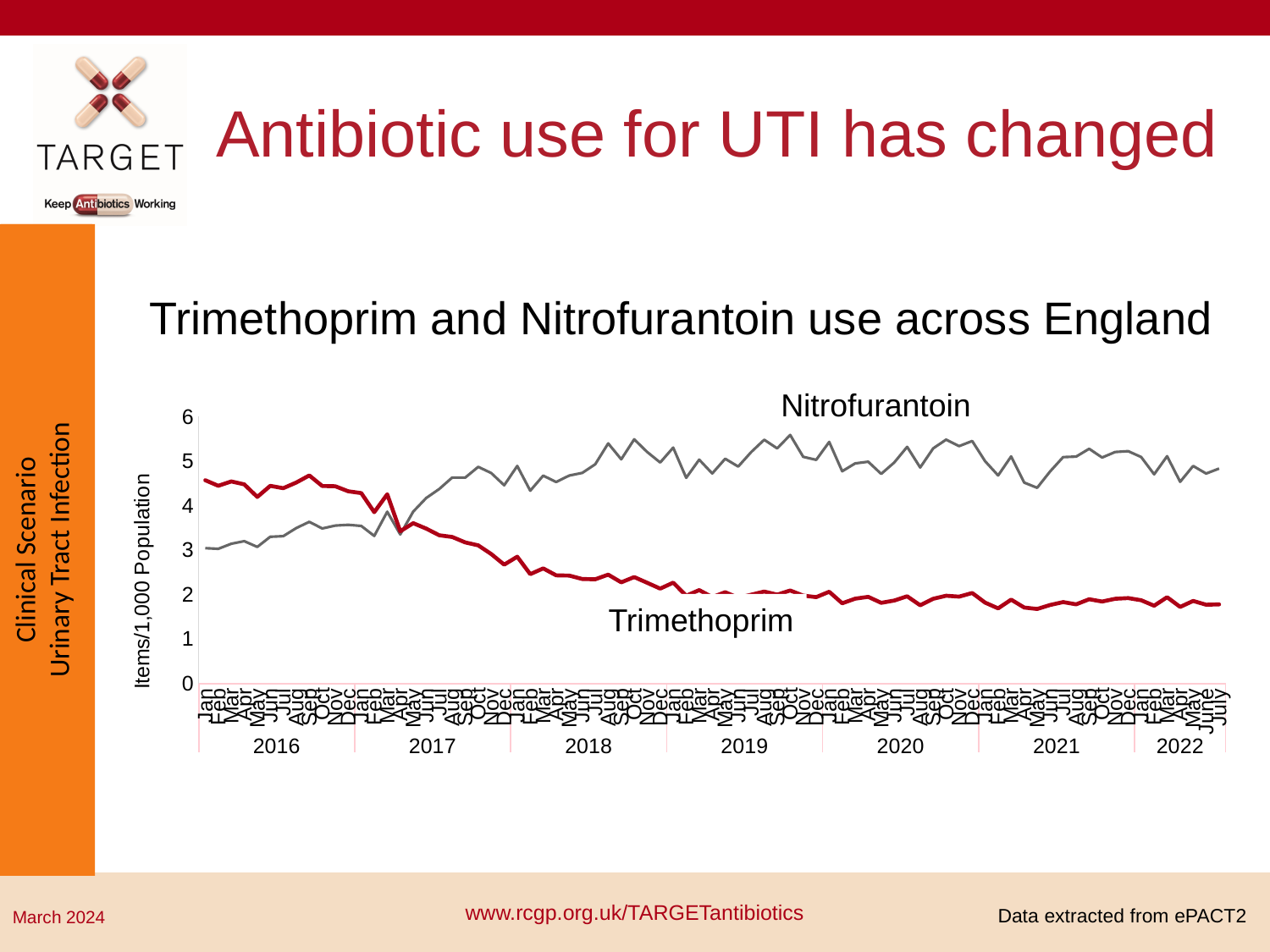
Is the value for Trimethoprim in January 2016 greater or less than 4? greater What is the title of the chart? Trimethoprim and Nitrofurantoin use across England Does Trimethoprim use rise or fall from 2016 to 2022? fall What kind of chart is shown on the slide? line chart How many series are plotted on the chart? 2 How many years are labelled along the x axis of the chart? 7 Is the value for Nitrofurantoin in July 2022 greater or less than 4? greater Which series has the higher value in 2021, Trimethoprim or Nitrofurantoin? Nitrofurantoin What is the label on the y axis of the chart? Items/1,000 Population Is the value for Trimethoprim in July 2022 greater or less than 3? less Does Nitrofurantoin use rise or fall from 2016 to 2022? rise Which series has the higher value in January 2016, Trimethoprim or Nitrofurantoin? Trimethoprim